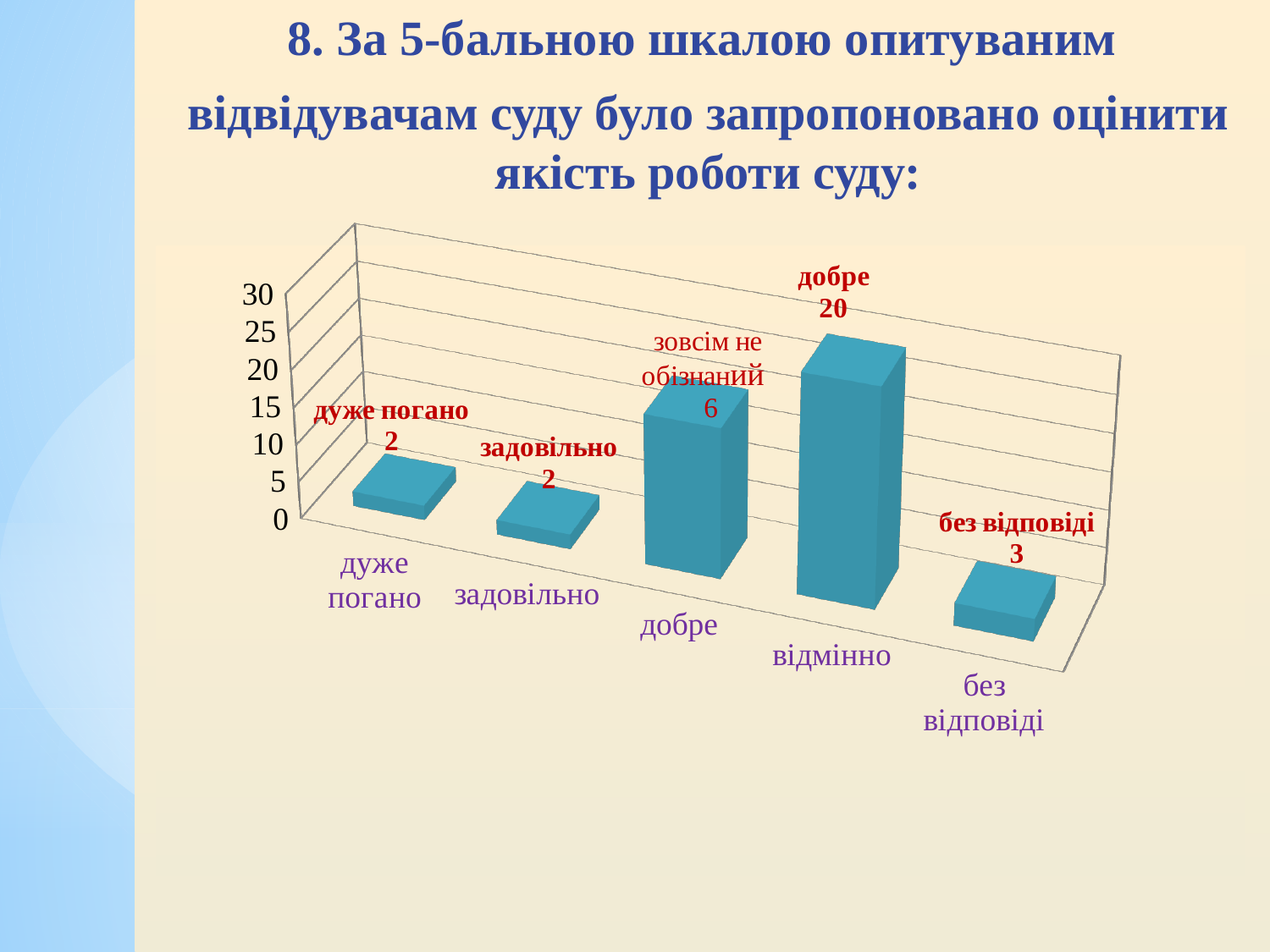
Which is larger, the value for "без відповіді" or the value for "дуже погано"? без відповіді How many bars does the chart have? 5 What is the value shown for the bar labelled "без відповіді"? 3 What is the value printed on the tallest bar in the chart? 20 What value is printed on the bar labelled "зовсім не обізнаний"? 6 Which x-axis category has the tallest bar? відмінно What is the value shown for the bar labelled "дуже погано"? 2 What kind of chart is shown on the slide? bar chart What is the value shown for the bar labelled "задовільно"? 2 Is the value of the tallest bar greater or less than 15? greater What colour are the bars in the chart? blue (teal)